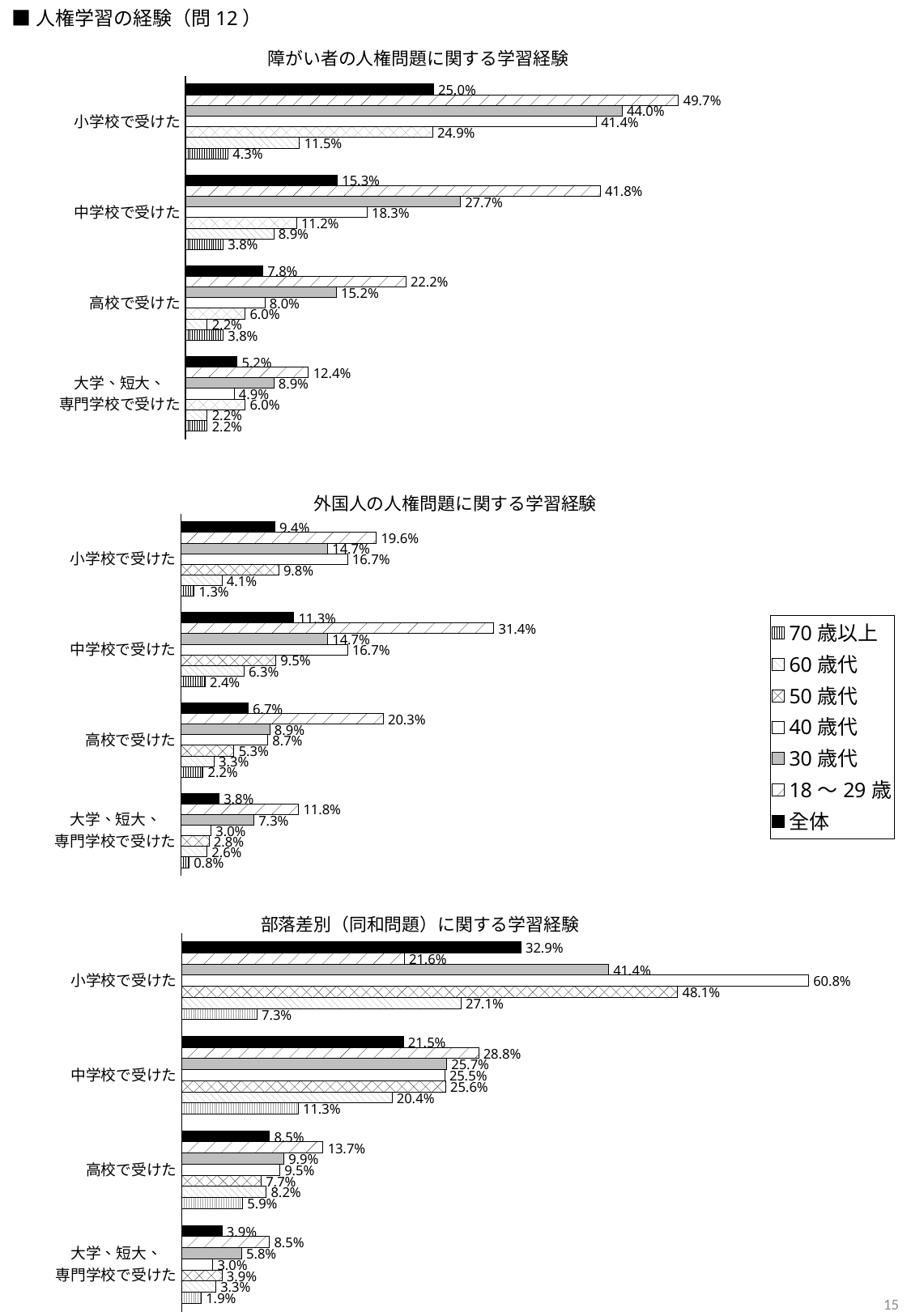
In the chart titled 部落差別（同和問題）に関する学習経験, what is the difference between the 全体 values for 小学校で受けた and 中学校で受けた? 11.4% In the chart titled 部落差別（同和問題）に関する学習経験, what is the value for 70歳以上 in the 中学校で受けた category? 11.3% In the chart titled 障がい者の人権問題に関する学習経験, what is the value for 全体 in the 小学校で受けた category? 25.0% In the chart titled 障がい者の人権問題に関する学習経験, what is the difference between the 18～29歳 and 全体 values in the 高校で受けた category? 14.4% What kind of chart is the chart titled 部落差別（同和問題）に関する学習経験? Bar chart In the chart titled 外国人の人権問題に関する学習経験, is the 全体 value larger for 小学校で受けた or for 中学校で受けた? 中学校で受けた In the chart titled 障がい者の人権問題に関する学習経験, what is the value for 18～29歳 in the 中学校で受けた category? 41.8% In the chart titled 外国人の人権問題に関する学習経験, which age group has the lowest value in the 大学、短大、専門学校で受けた category? 70歳以上 How many series does the legend on the slide list? 7 In the chart titled 外国人の人権問題に関する学習経験, what is the value for 全体 in the 中学校で受けた category? 11.3% In the chart titled 障がい者の人権問題に関する学習経験, which age group has the highest value in the 小学校で受けた category? 18～29歳 In the chart titled 部落差別（同和問題）に関する学習経験, what is the value for 40歳代 in the 小学校で受けた category? 60.8%